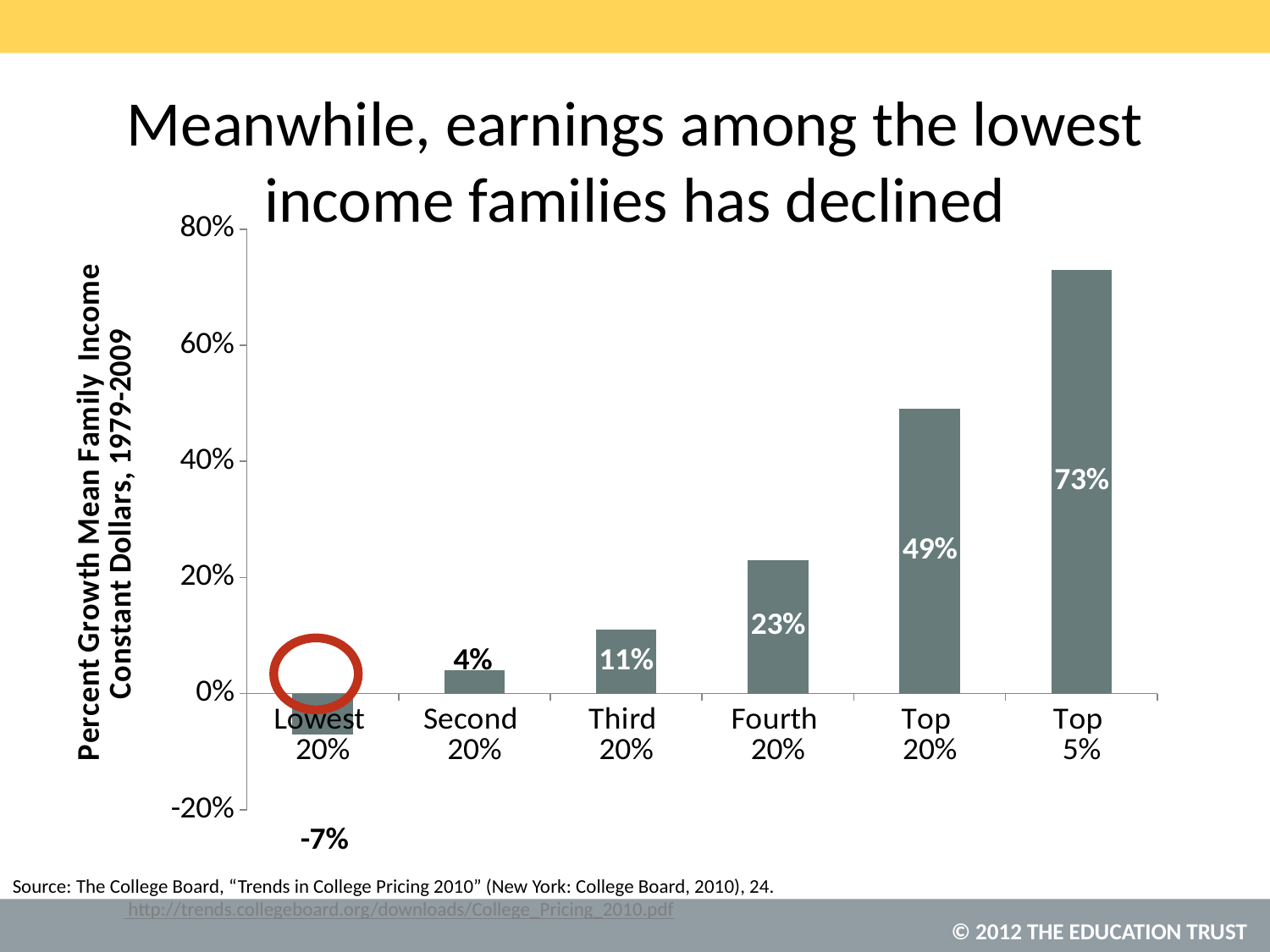
Is the value for the Top 20% greater or less than 40%? greater What is the percent growth in mean family income for the Lowest 20%? -7% Which group has a larger percent growth, the Second 20% or the Third 20%? Third 20% Which income group has the highest percent growth in mean family income? Top 5% How many income groups are shown on the chart? 6 What is the difference between the percent growth for the Top 20% and the Fourth 20%? 26 percentage points What is the label on the vertical axis of the chart? Percent Growth Mean Family Income Constant Dollars, 1979-2009 What is the value shown for the Fourth 20% group? 23% Which income group has the lowest percent growth in mean family income? Lowest 20% Do the values rise or fall moving from the Lowest 20% to the Top 5% along the x axis? Rise What is the percent growth in mean family income for the Top 5%? 73% What kind of chart is shown on the slide? Bar chart